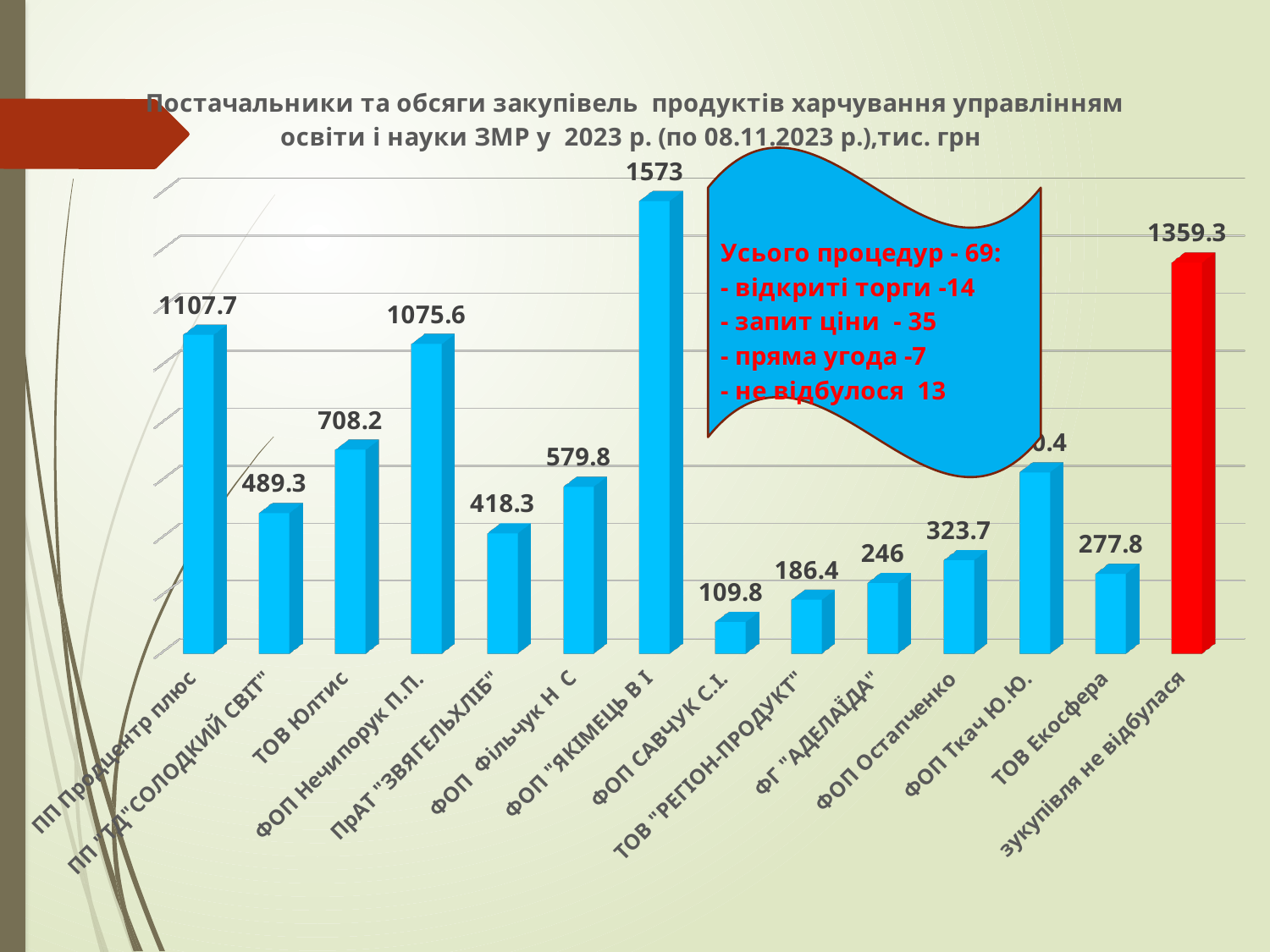
What kind of chart is shown on the slide? Bar chart Which category is shown with a red bar instead of a blue one? закупівля не відбулася What is the difference between the values for ТОВ Юлтис and ПП "ТД "СОЛОДКИЙ СВІТ"? 218.9 What is the value for the category "закупівля не відбулася"? 1359.3 What is the value for ТОВ Екосфера? 277.8 According to the text box on the chart, what is the total number of procedures (Усього процедур)? 69 What is the value for ФОП Нечипорук П.П.? 1075.6 Which category has the lowest value? ФОП САВЧУК С.І. How many categories are shown on the chart? 14 Which category has the highest value? ФОП "ЯКІМЕЦЬ В І" What is the value for ПП Продцентр плюс? 1107.7 Which is larger, the value for ФОП Фільчук Н С or the value for ПрАТ "ЗВЯГЕЛЬХЛІБ"? ФОП Фільчук Н С